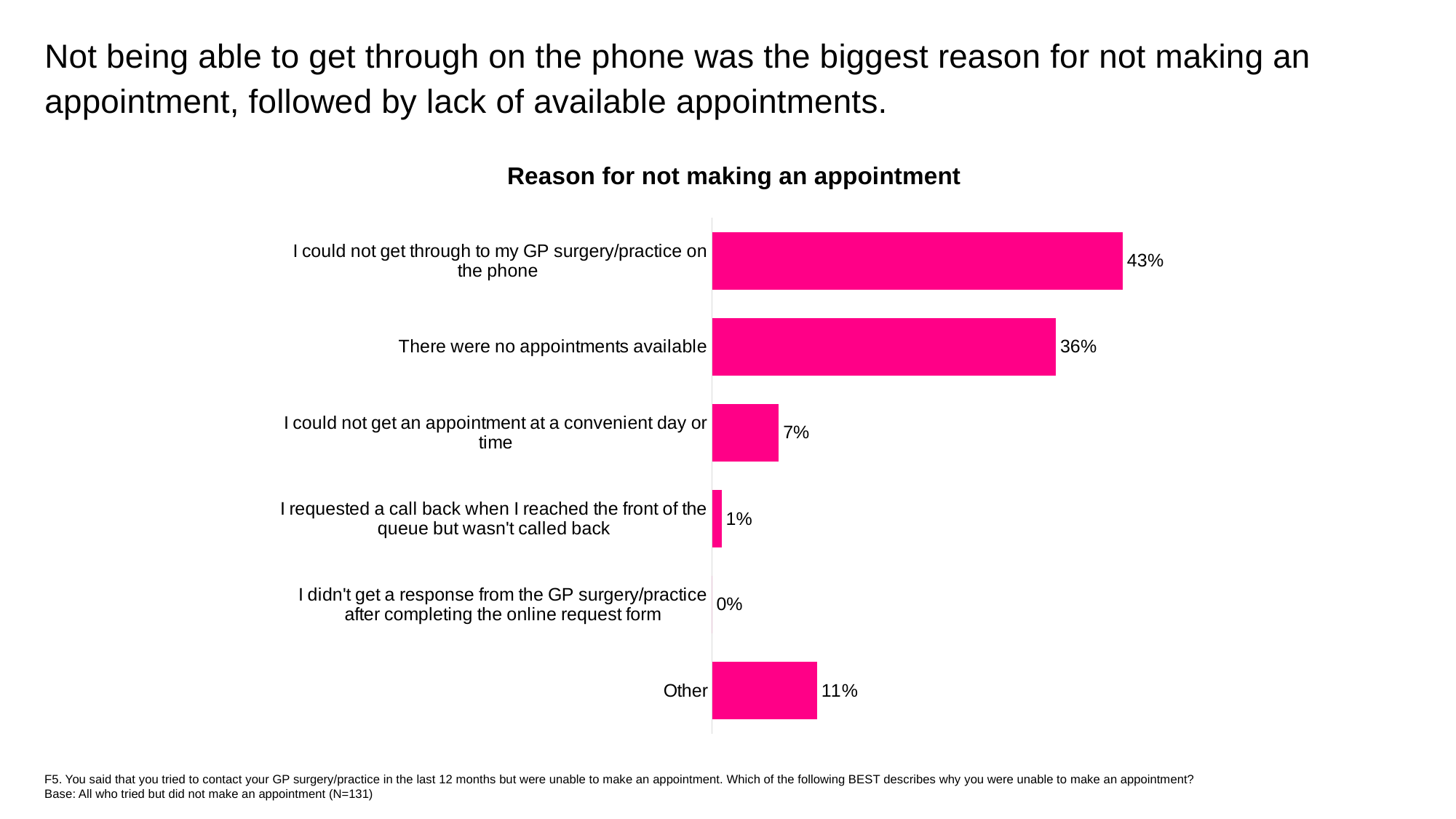
How many reasons (categories) are shown in the chart? 6 What is the value for 'There were no appointments available'? 36% What percentage said they could not get an appointment at a convenient day or time? 7% Which is larger: the value for 'Other' or the value for 'I could not get an appointment at a convenient day or time'? Other Which reason has the highest value? I could not get through to my GP surgery/practice on the phone Which reason has the lowest value? I didn't get a response from the GP surgery/practice after completing the online request form What is the value for 'Other'? 11% What is the title of the chart? Reason for not making an appointment What type of chart is shown on the slide? Bar chart What is the difference between the value for not getting through on the phone and the value for no appointments available? 7 percentage points What percentage of respondents said they could not get through to their GP surgery/practice on the phone? 43% What percentage said they didn't get a response from the GP surgery/practice after completing the online request form? 0%